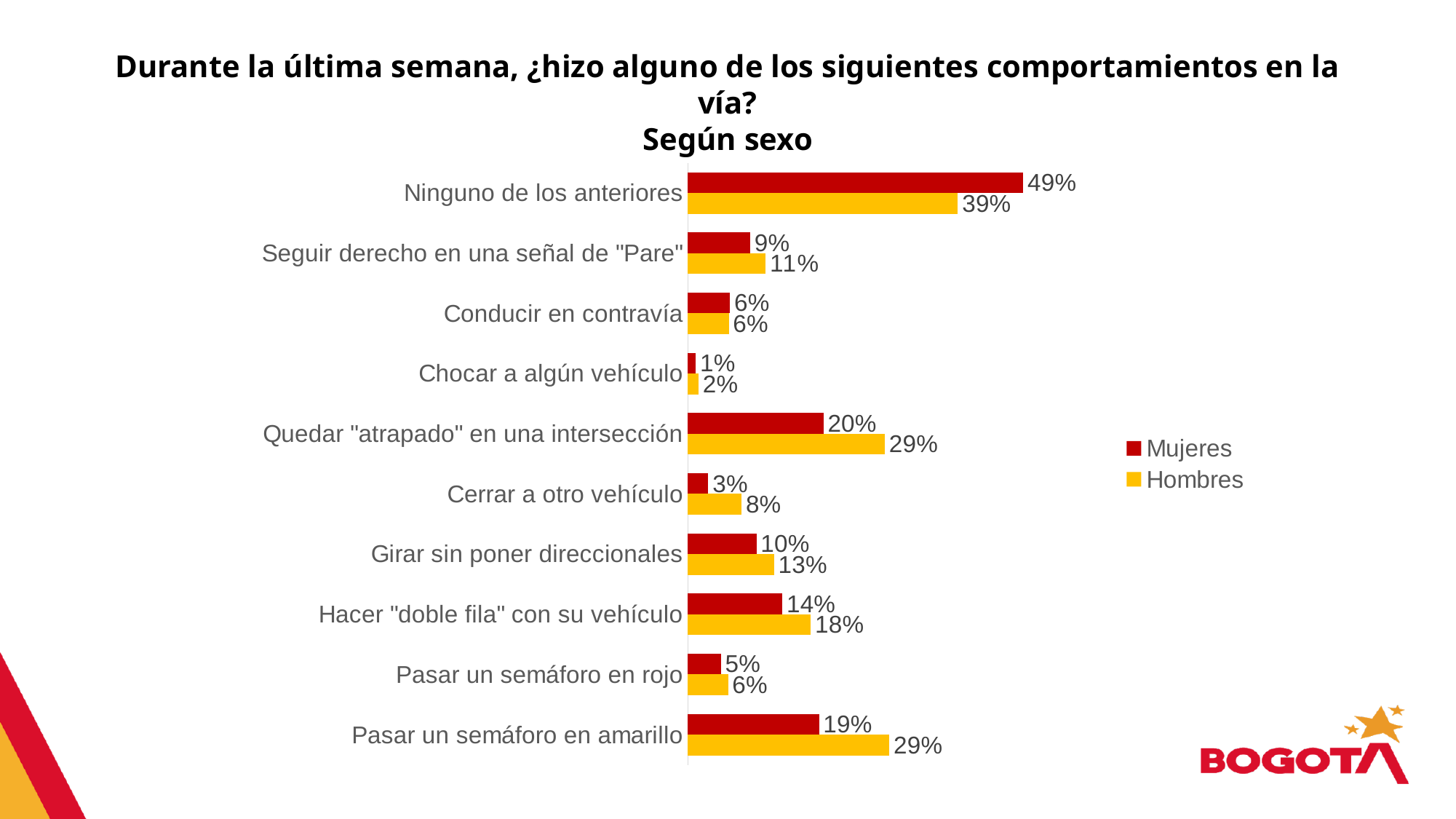
Which category has the highest value for Hombres? Ninguno de los anteriores What is the value for Hombres for "Pasar un semáforo en rojo"? 6% What is the difference between Hombres and Mujeres for "Pasar un semáforo en amarillo"? 10% Which colour represents Hombres in the chart? Yellow How many categories are shown on the chart? 10 What is the value for Hombres for "Quedar "atrapado" en una intersección"? 29% What kind of chart is shown on the slide? Bar chart What is the value for Mujeres for "Ninguno de los anteriores"? 49% Which is larger for "Cerrar a otro vehículo": Mujeres or Hombres? Hombres How many series does the legend list? 2 What is the difference between Mujeres and Hombres for "Ninguno de los anteriores"? 10% Which category has the lowest value for Mujeres? Chocar a algún vehículo